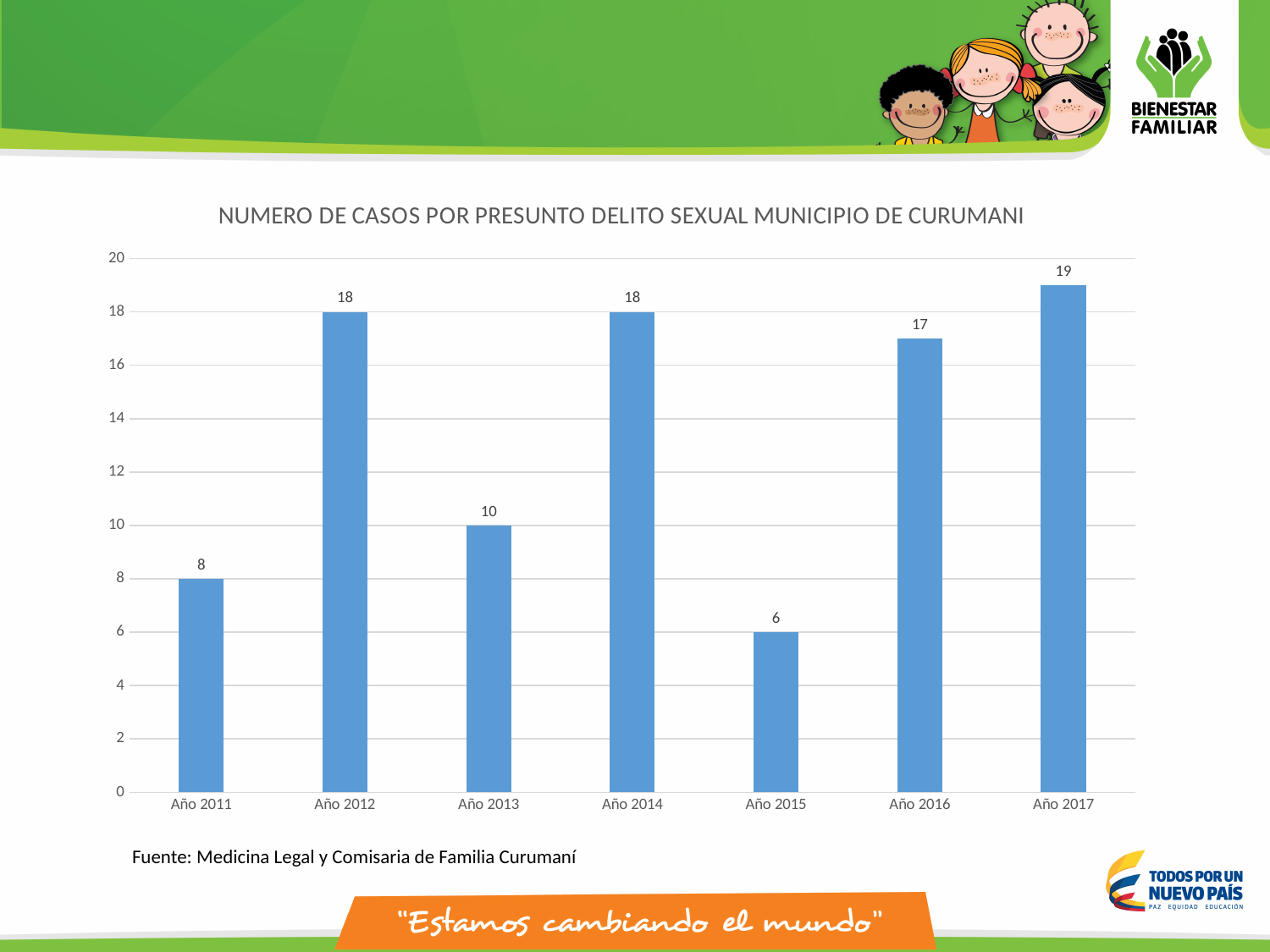
What kind of chart is shown on the slide? Bar chart Is the value for Año 2014 greater or less than 16? greater What is the difference in cases between Año 2017 and Año 2015? 13 What is the number of cases for Año 2016? 17 How many years are shown on the x axis? 7 Which year has the lowest number of cases? Año 2015 What is the number of cases for Año 2015? 6 What is the title of the chart? NUMERO DE CASOS POR PRESUNTO DELITO SEXUAL MUNICIPIO DE CURUMANI What is the number of cases for Año 2011? 8 Which has more cases, Año 2013 or Año 2016? Año 2016 What is the difference in cases between Año 2012 and Año 2013? 8 Which year has the highest number of cases? Año 2017